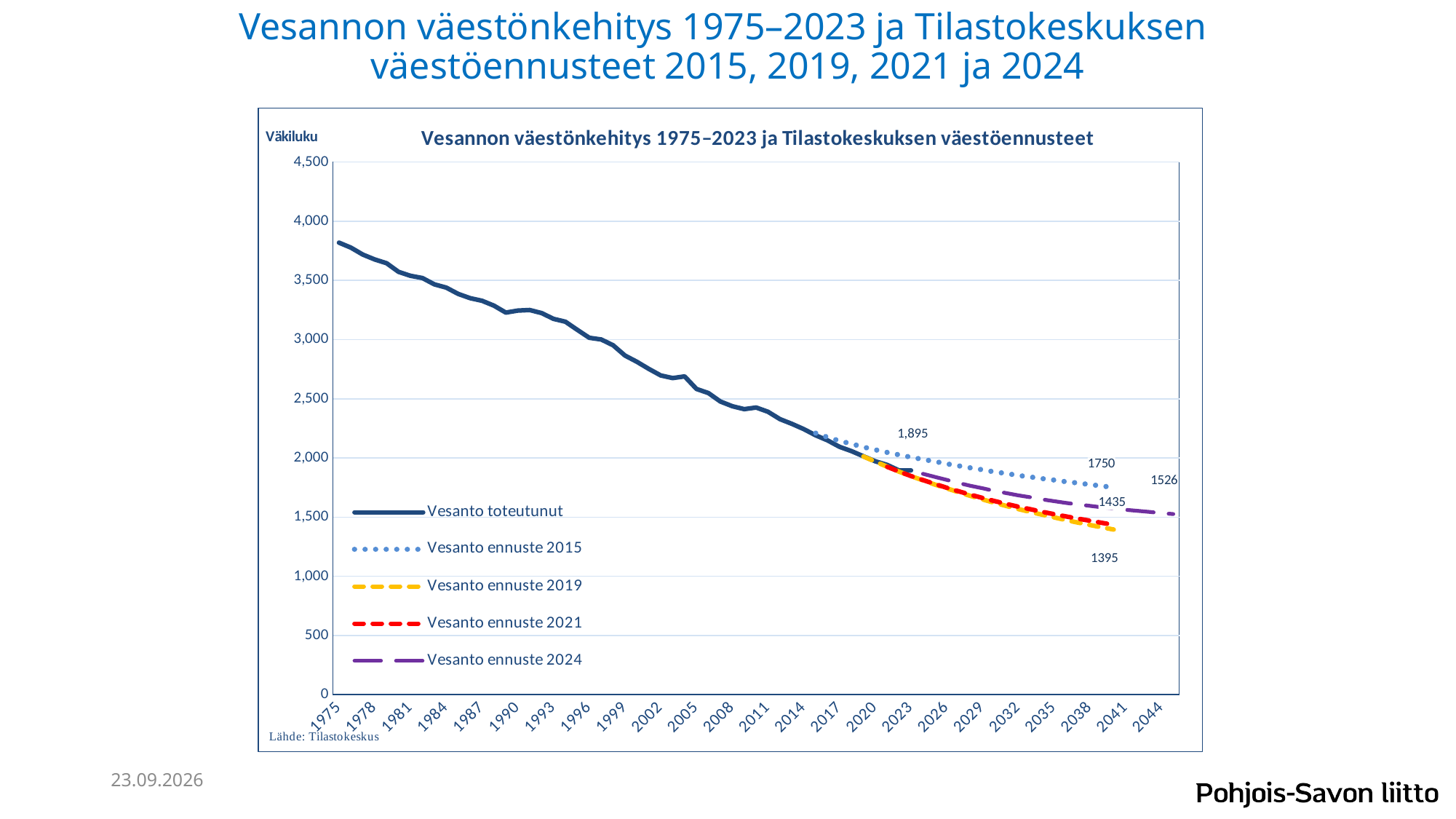
What is the difference between the labelled end values of Vesanto ennuste 2015 and Vesanto ennuste 2019? 355 What kind of chart is shown on the slide? line chart Is the value of Vesanto toteutunut in 1975 greater or less than 3,500? greater Does the Vesanto toteutunut line rise or fall from 1975 to 2023? fall Which forecast series ends at the lowest labelled value? Vesanto ennuste 2019 What is the label on the vertical axis of the chart? Väkiluku What is the labelled end value of the Vesanto ennuste 2015 line? 1750 How many series does the legend list? 5 What is the labelled end value of the Vesanto ennuste 2024 line? 1526 What is the labelled end value of the Vesanto ennuste 2019 line? 1395 Which forecast series ends at the highest labelled value? Vesanto ennuste 2015 What is the labelled end value of the Vesanto ennuste 2021 line? 1435